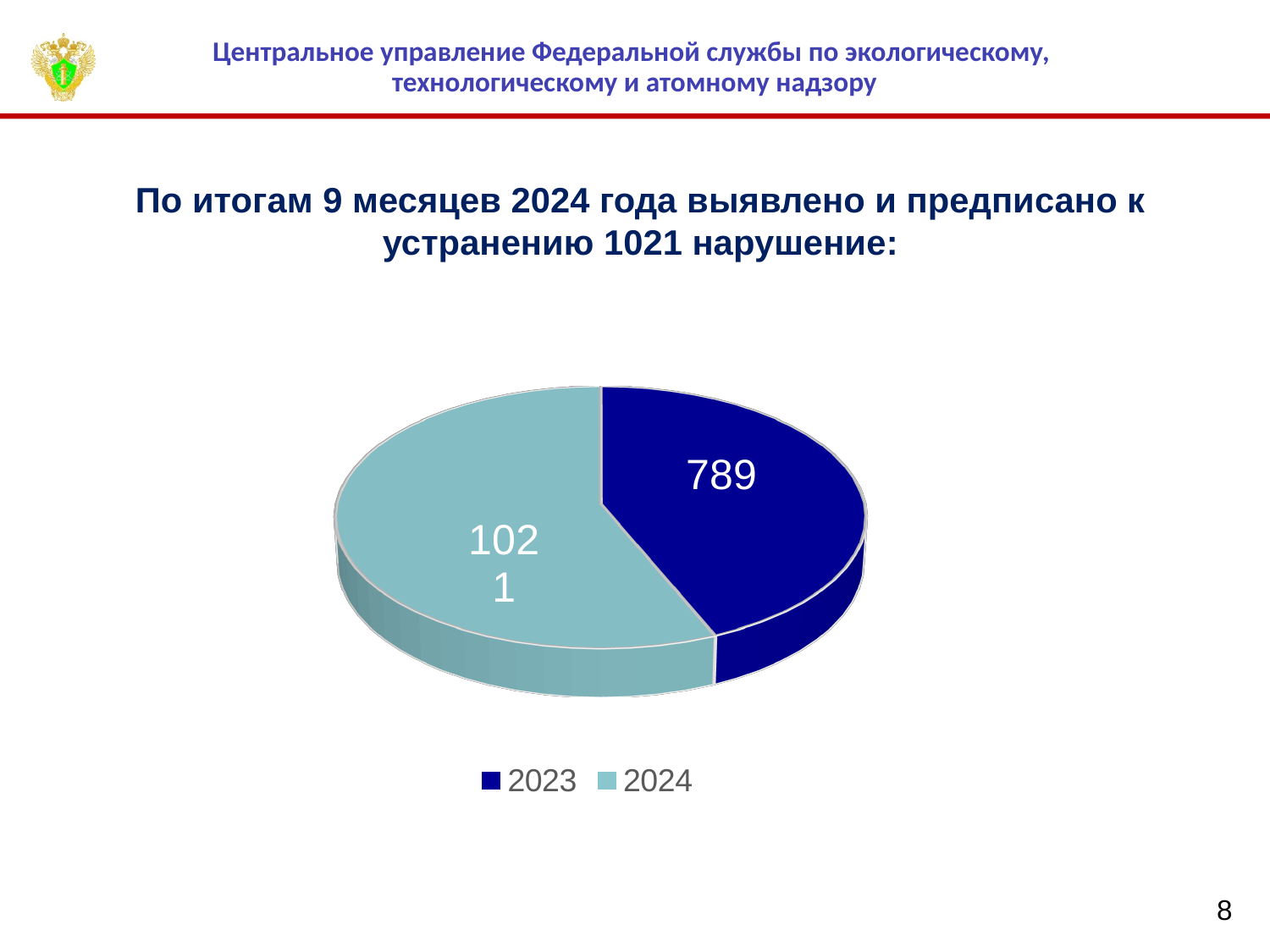
By how much does the 2024 value exceed the 2023 value in the pie chart? 232 Which year has the larger slice in the pie chart? 2024 Which year has the smaller slice in the pie chart? 2023 What value is shown for the 2024 slice of the pie chart? 1021 How many entries does the legend of the pie chart list? 2 Is the value for 2023 larger or smaller than the value for 2024? smaller What value is shown for the 2023 slice of the pie chart? 789 How many slices does the pie chart have? 2 Which legend entry is shown in light blue (teal)? 2024 Which legend entry is shown in dark blue? 2023 What type of chart is shown on the slide? pie chart